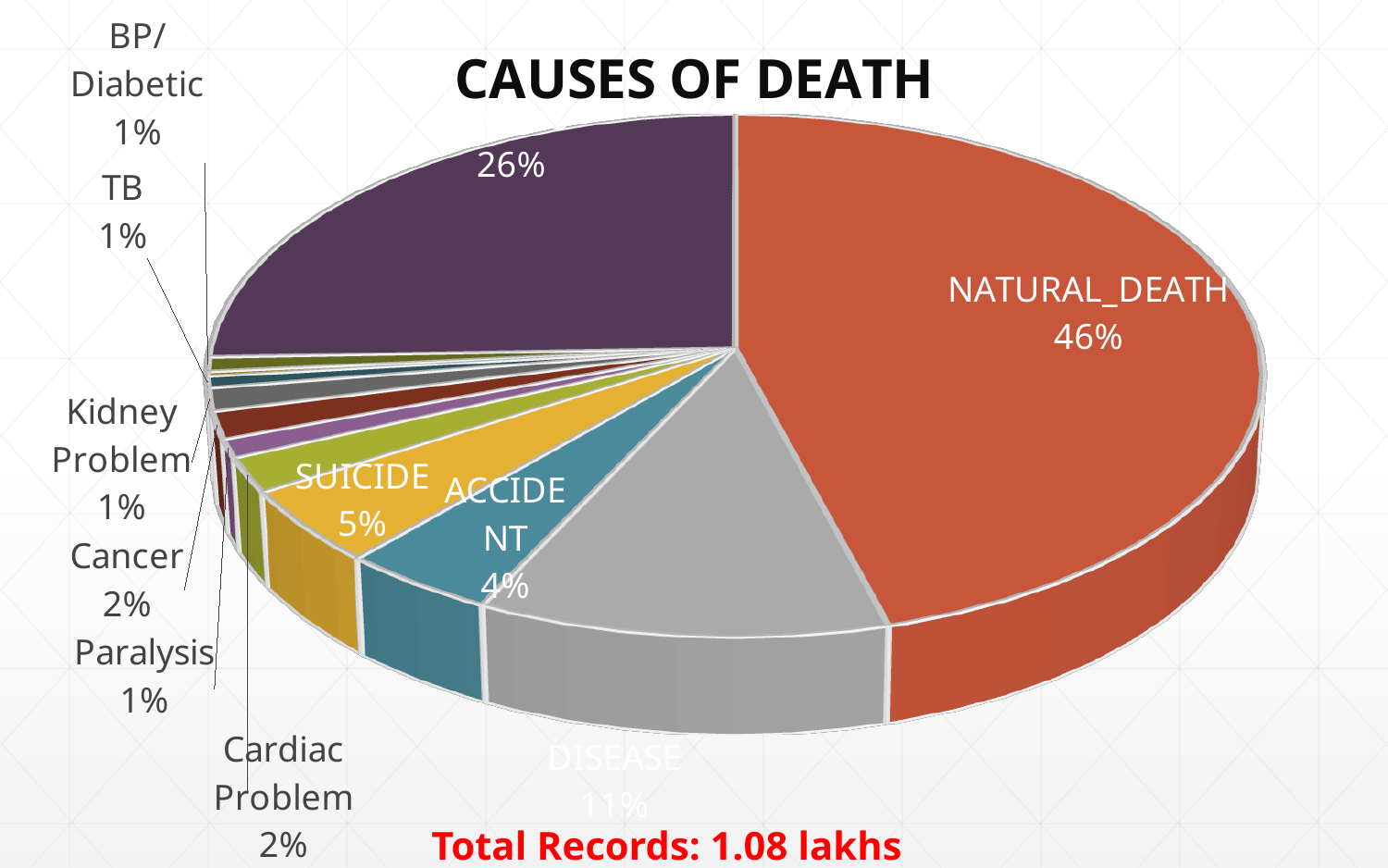
What kind of chart is shown on the slide? pie chart What share does SUICIDE account for? 5% Which cause of death has the largest slice of the pie? NATURAL_DEATH What share of deaths is attributed to NATURAL_DEATH? 46% What percentage of the pie is DISEASE? 11% What is the difference in percentage points between NATURAL_DEATH and DISEASE? 35 Which is larger, the share for SUICIDE or the share for ACCIDENT? SUICIDE What is the title of the chart? CAUSES OF DEATH What total number of records does the slide state the chart is based on? 1.08 lakhs